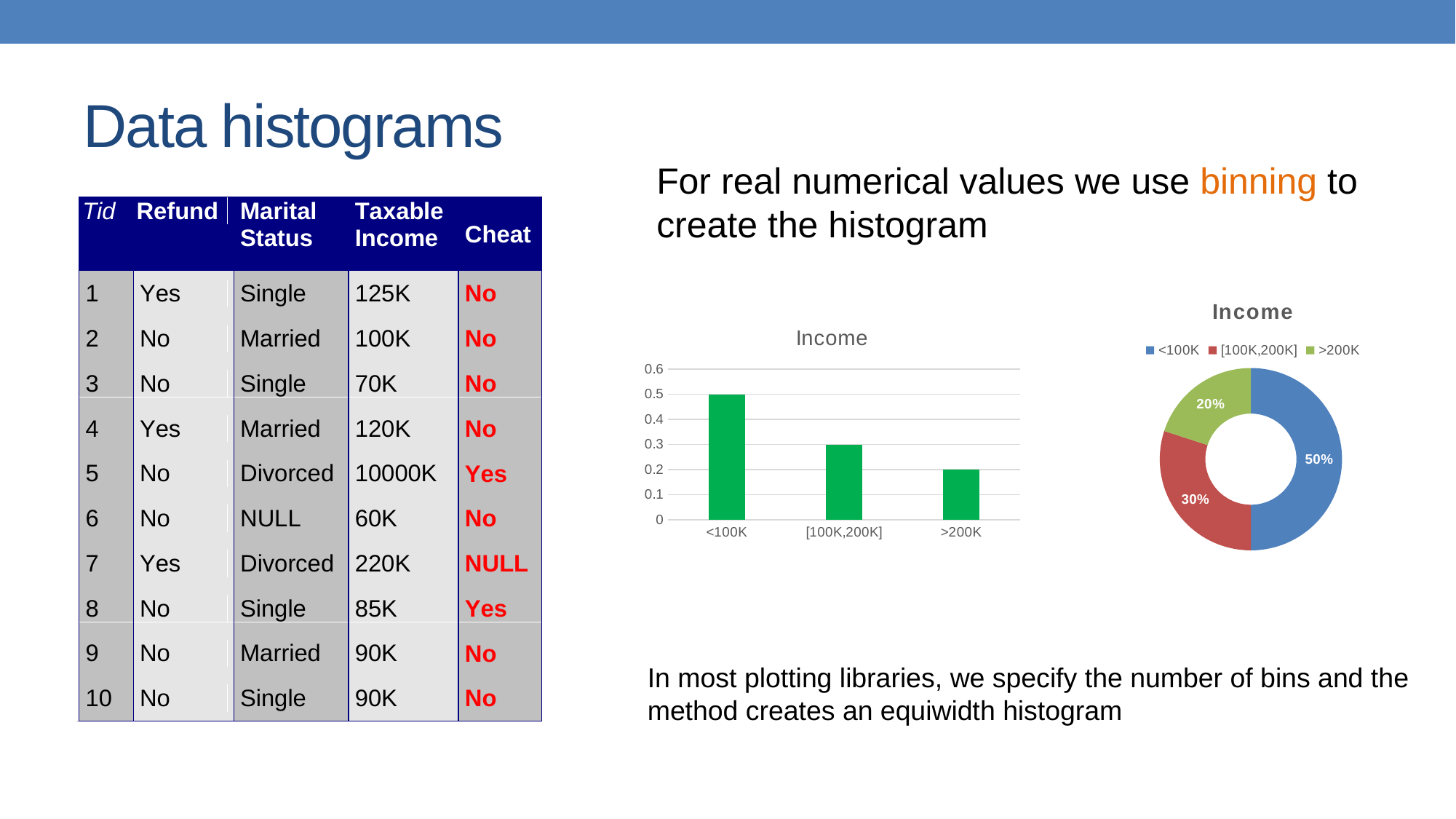
In the bar chart on the left, which bin has the lowest value? >200K In the bar chart on the left, what is the value for the >200K bin? 0.2 In the bar chart on the left, how many bins are shown on the x axis? 3 In the doughnut chart on the right, what share does the <100K slice have? 50% In the bar chart on the left, which bin has the highest value? <100K In the bar chart on the left, what is the value for the <100K bin? 0.5 How many entries does the legend of the doughnut chart on the right list? 3 In the bar chart on the left, what is the value for the [100K,200K] bin? 0.3 In the doughnut chart on the right, what is the difference between the [100K,200K] share and the >200K share? 10% In the bar chart on the left, do the values rise or fall from left to right along the x axis? fall In the doughnut chart on the right, what share does the >200K slice have? 20% What kind of chart is the chart on the left? bar chart